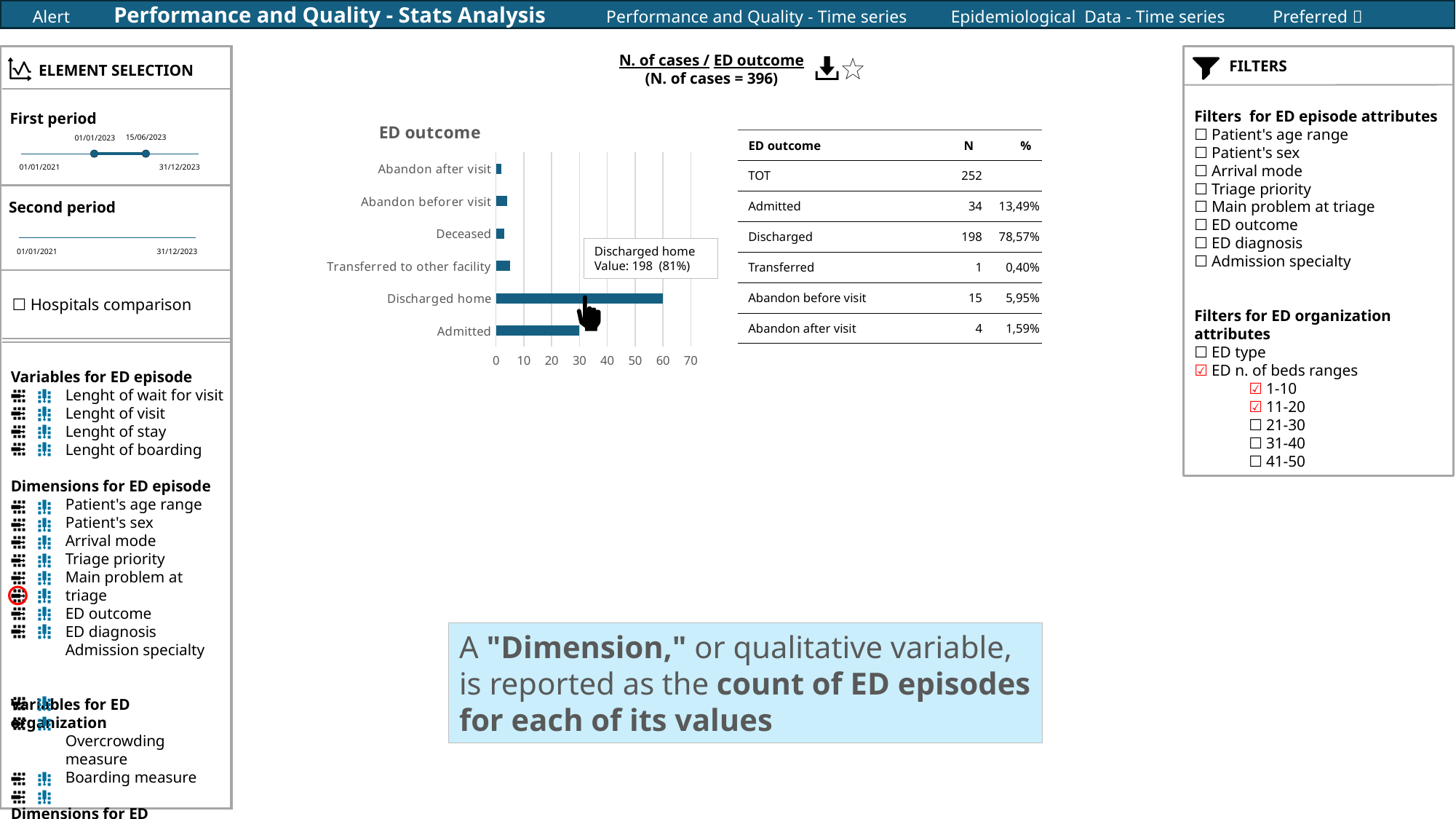
According to the tooltip on the chart, what is the value for Discharged home? 198 According to the tooltip on the chart, what percentage is shown for Discharged home? 81% Which ED outcome category has the longest bar in the chart? Discharged home In the ED outcome chart, which bar is longer: Transferred to other facility or Deceased? Transferred to other facility What is the title of the bar chart? ED outcome In the ED outcome chart, which bar is longer: Discharged home or Admitted? Discharged home How many ED outcome categories are plotted in the bar chart? 6 Is the bar for Admitted in the ED outcome chart greater or less than 20 on the x axis? greater Which ED outcome category has the shortest bar in the chart? Abandon after visit What is the highest tick value shown on the x axis of the ED outcome chart? 70 Is the bar for Transferred to other facility in the ED outcome chart greater or less than 10 on the x axis? less What kind of chart is shown under the title 'ED outcome'? bar chart